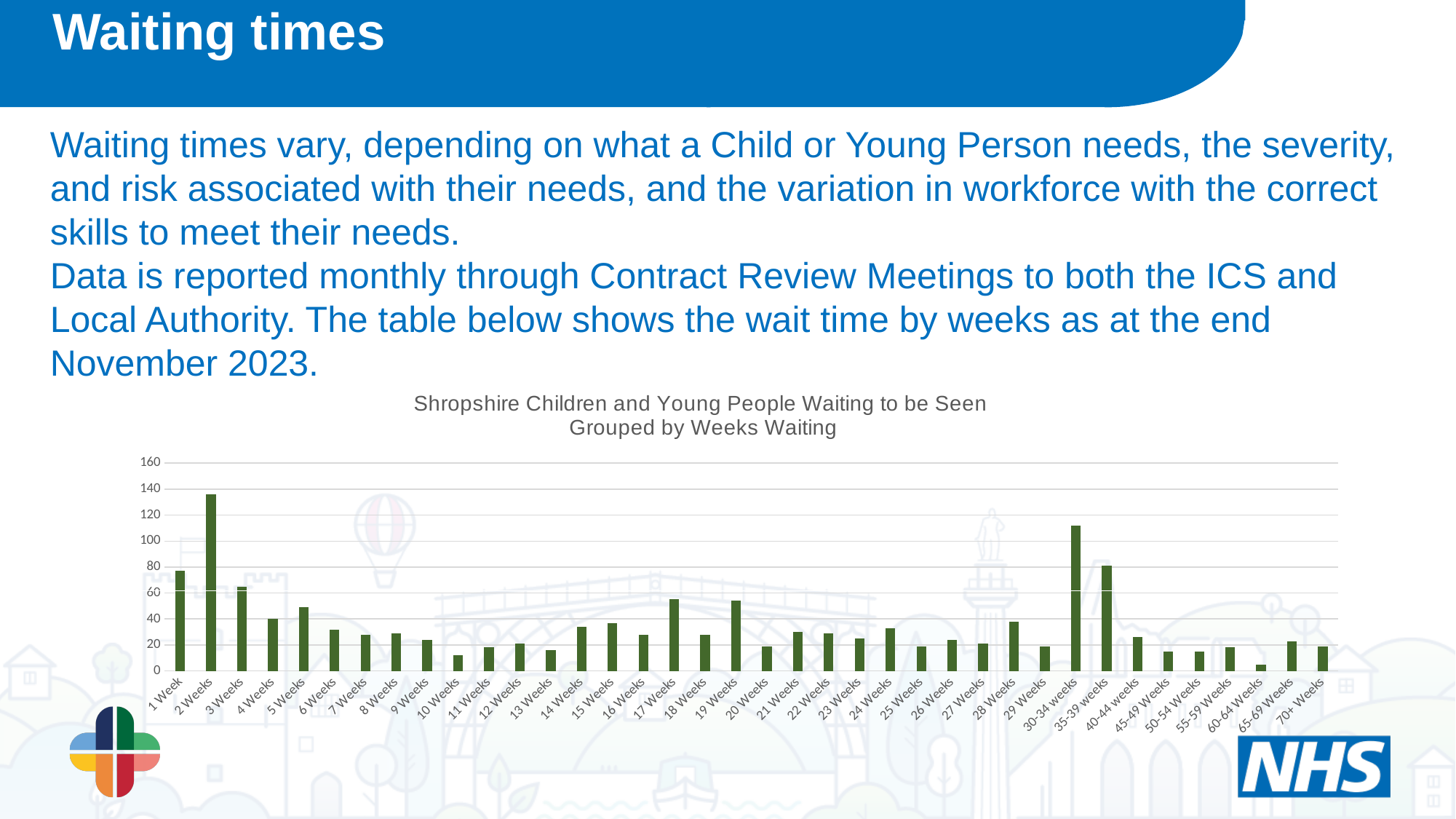
Which is larger, the value for 5 Weeks or the value for 6 Weeks? 5 Weeks Is the value for 30-34 weeks greater or less than 100? greater Is the value for 2 Weeks greater or less than 120? greater Which weeks-waiting category has the lowest number of children and young people waiting? 60-64 weeks Is the value for 1 Week greater or less than 60? greater How many categories (weeks-waiting groups) are shown on the x axis? 38 Which is larger, the value for 2 Weeks or the value for 30-34 weeks? 2 Weeks What is the title of the chart? Shropshire Children and Young People Waiting to be Seen Grouped by Weeks Waiting Which weeks-waiting category has the highest number of children and young people waiting? 2 Weeks What kind of chart is shown on the slide? bar chart